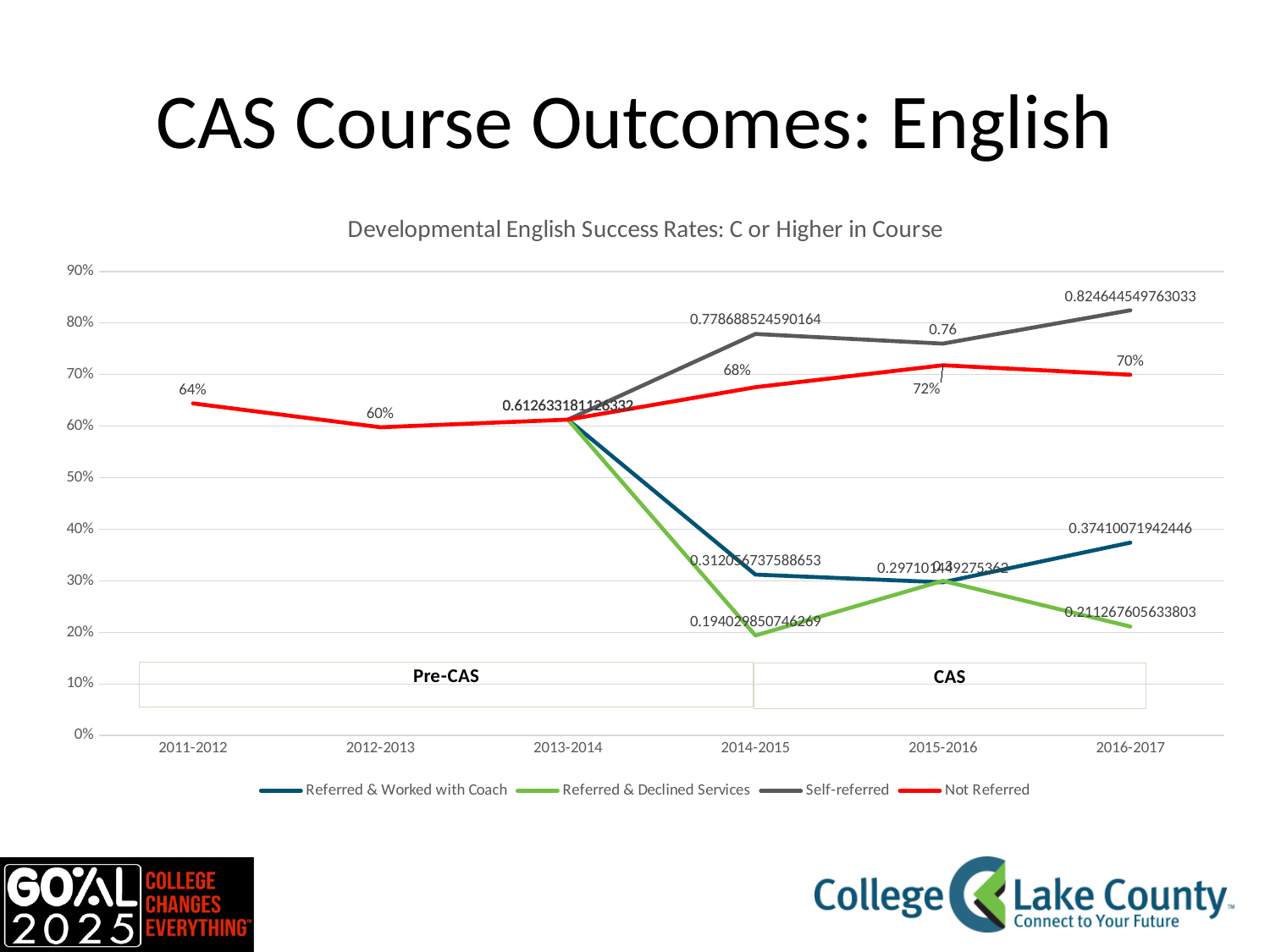
In 2016-2017, which is higher: Self-referred or Not Referred? Self-referred What is the Referred & Worked with Coach value for 2016-2017? 0.37410071942446 What is the Self-referred success rate for 2016-2017? 0.824644549763033 How many series does the legend list? 4 In which year is the Not Referred success rate lowest? 2012-2013 What is the Referred & Declined Services value for 2014-2015? 0.194029850746269 What is the Not Referred success rate for 2011-2012? 64% How many academic years are shown on the x axis? 6 What is the difference between the Not Referred rates for 2015-2016 and 2012-2013? 12 percentage points What kind of chart is shown on the slide? Line chart In which year is the Not Referred success rate highest? 2015-2016 Is the Referred & Declined Services value for 2015-2016 greater or less than 40%? less